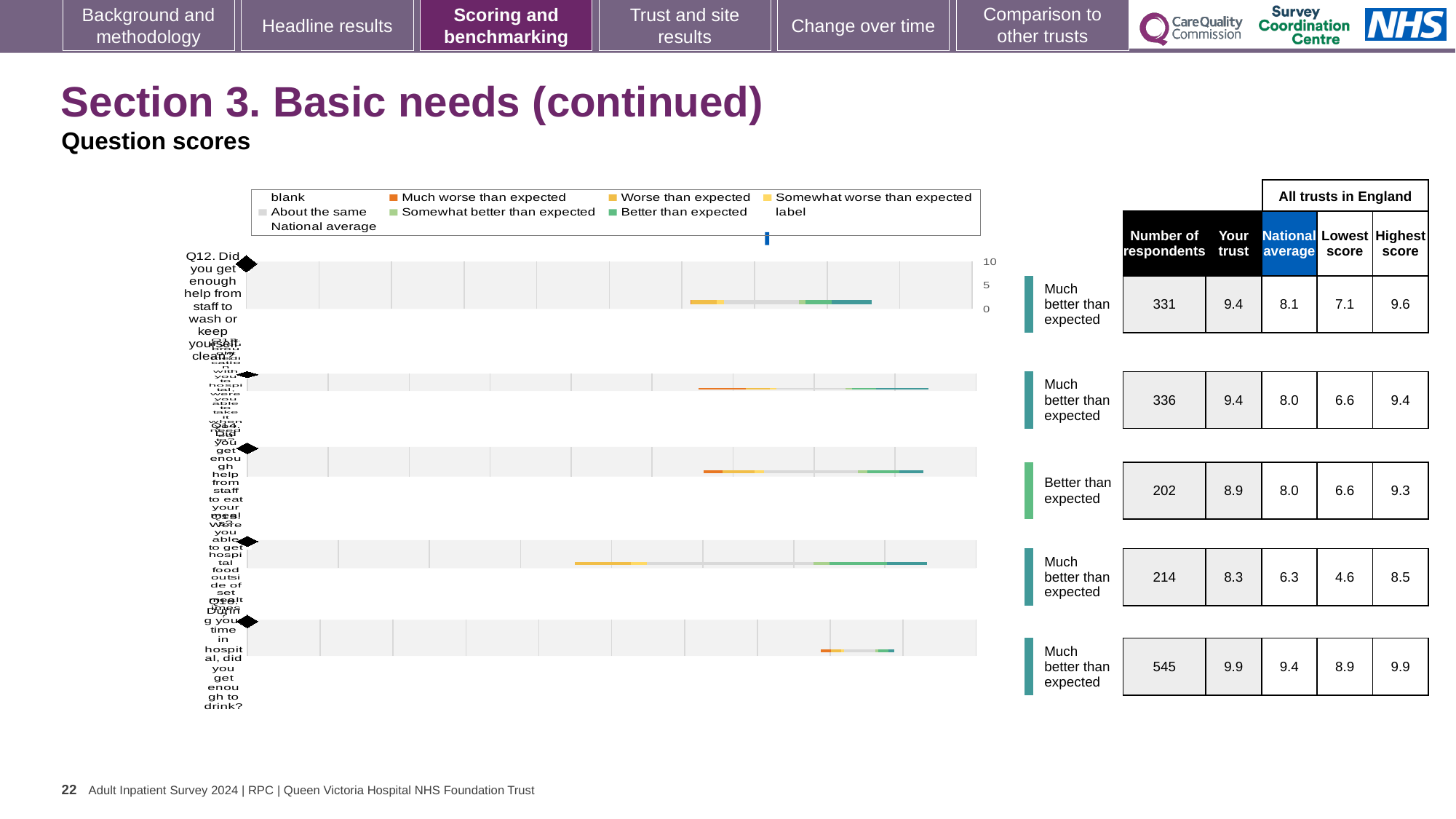
In the table beside the chart, what is the 'National average' score for Q16? 9.4 In the table beside the chart, how many respondents are listed for Q16 (did you get enough to drink)? 545 What benchmark label is shown next to the Q14 row (help from staff to eat your meals)? Better than expected Which question row has the lowest 'Your trust' score in the table beside the chart? Q15 How many survey questions (rows) are plotted in the chart? 5 Which question row has the highest 'Your trust' score in the table beside the chart? Q16 What kind of chart is shown on the slide? Bar chart In the table beside the chart, what is the lowest score across all trusts in England for Q15? 4.6 In the table beside the chart, what is the 'Your trust' score for Q12 (help from staff to wash or keep yourself clean)? 9.4 What colour does the chart legend use for 'Much worse than expected'? Orange Which has the higher 'Your trust' score in the table beside the chart, Q12 or Q14? Q12 For Q15, what is the difference between the 'Your trust' score and the 'National average' in the table beside the chart? 2.0